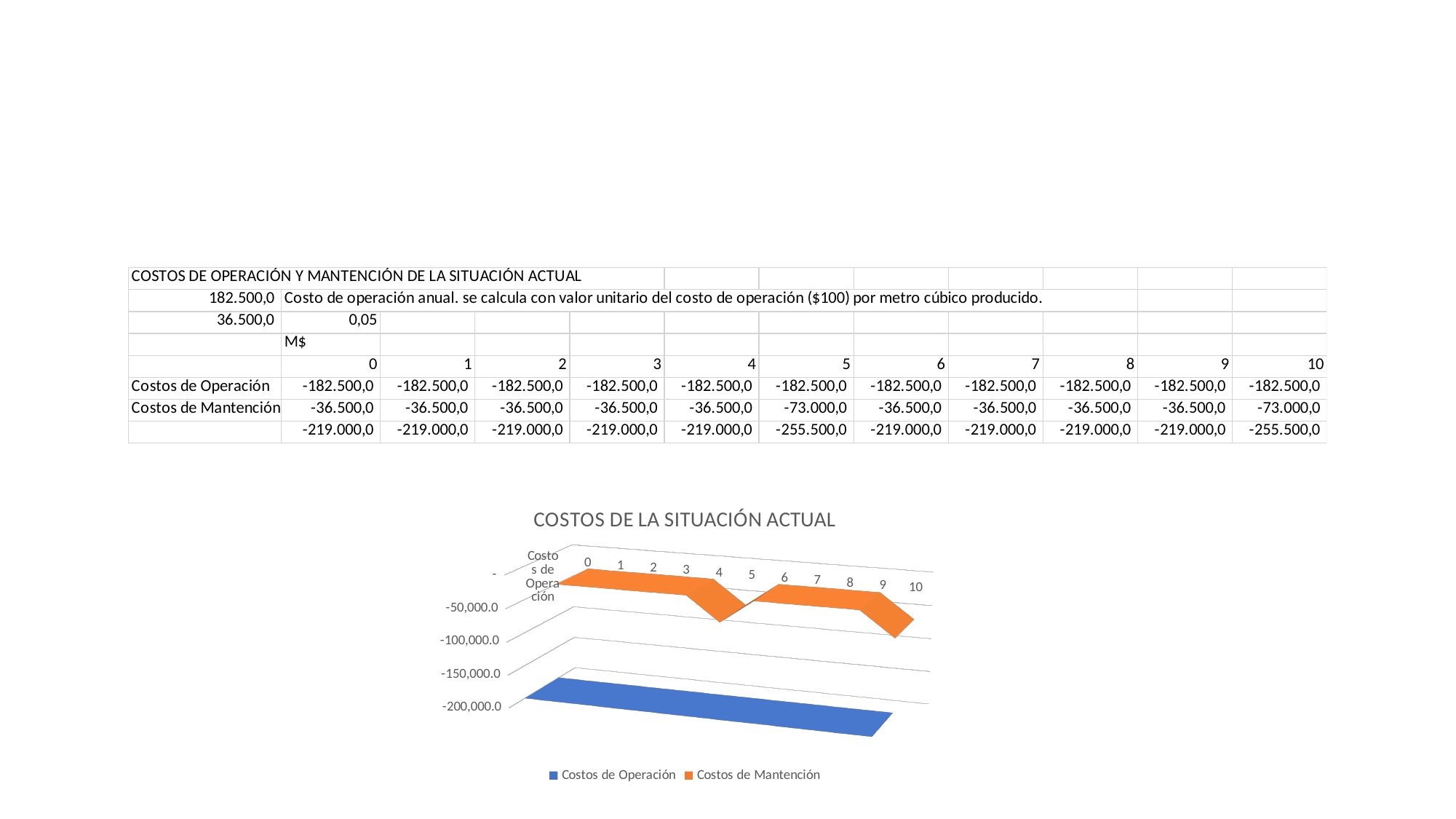
Is the value of Costos de Operación at period 0 greater or less than -150,000.0? less How many series does the legend of the chart 'COSTOS DE LA SITUACIÓN ACTUAL' list? 2 At period 3, which series has the larger (less negative) value, Costos de Operación or Costos de Mantención? Costos de Mantención What kind of chart is shown under the title 'COSTOS DE LA SITUACIÓN ACTUAL'? 3D line chart Is the value of Costos de Mantención at period 2 greater or less than -50,000.0? greater Which colour represents Costos de Mantención in the chart? orange How many points (periods) are plotted along the x axis of the chart? 11 Is the value of Costos de Mantención at period 5 greater or less than -50,000.0? less According to the table on the slide, what is the value of Costos de Mantención at period 10? -73.000,0 Does the Costos de Operación series rise, fall or stay flat across the x axis from 0 to 10? stays flat What are the two series named in the legend of the chart? Costos de Operación and Costos de Mantención According to the table on the slide, what is the value of Costos de Operación at period 4? -182.500,0